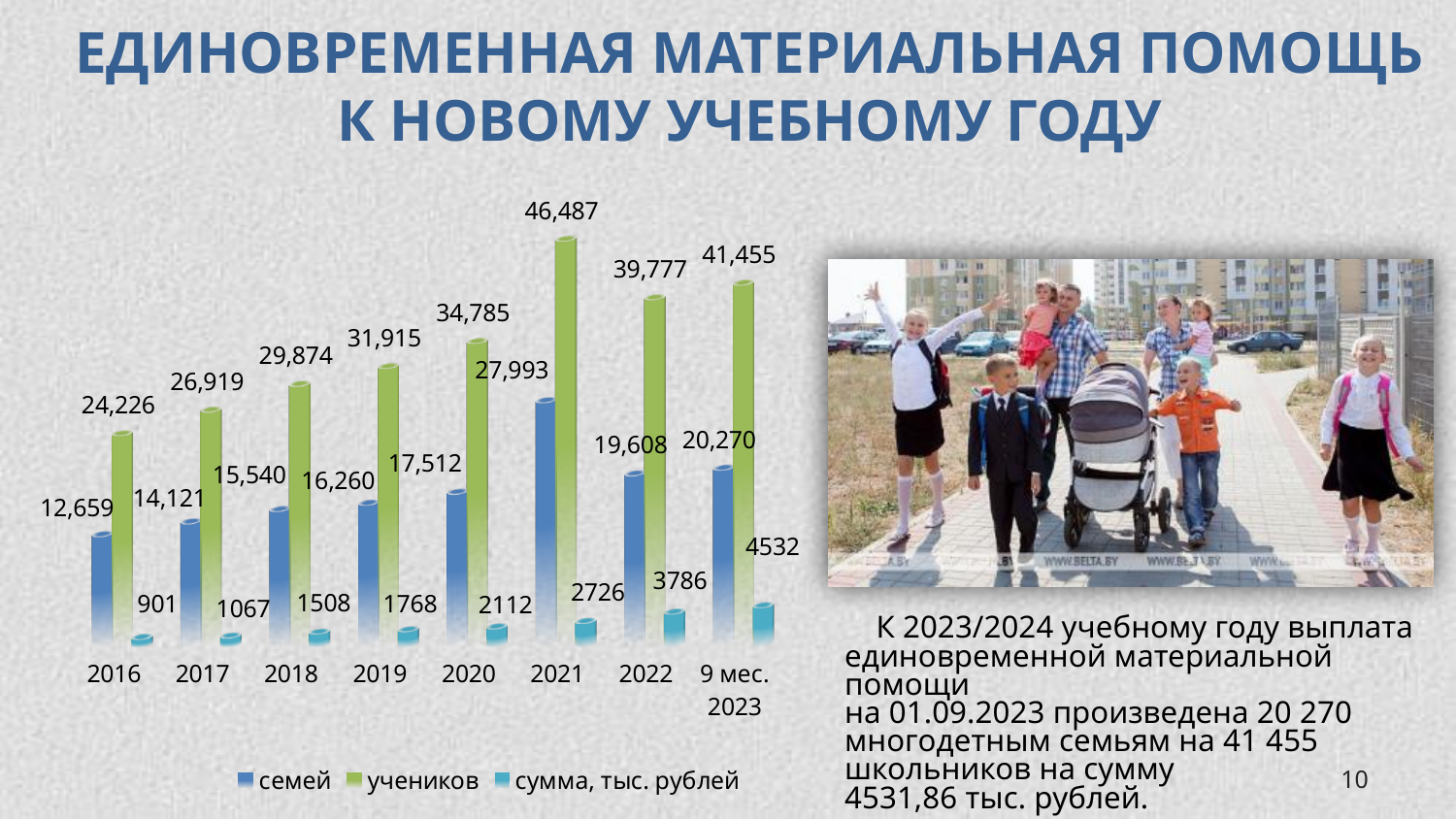
How many series does the chart legend list? 3 What is the difference between the учеников values for 2021 and 2022? 6,710 What is the value for семей in 2016? 12,659 How many categories (years) are shown on the x axis of the chart? 8 What kind of chart is shown on the slide? bar chart In which year is the value for учеников the highest? 2021 Do the values for сумма, тыс. рублей rise or fall from 2016 to 9 мес. 2023? rise What is the value for сумма, тыс. рублей in 2022? 3786 Which is larger: the семей value for 2020 or for 2022? 2022 In which year is the value for сумма, тыс. рублей the lowest? 2016 What is the value for учеников in 2021? 46,487 Which series is shown in green in the chart? учеников